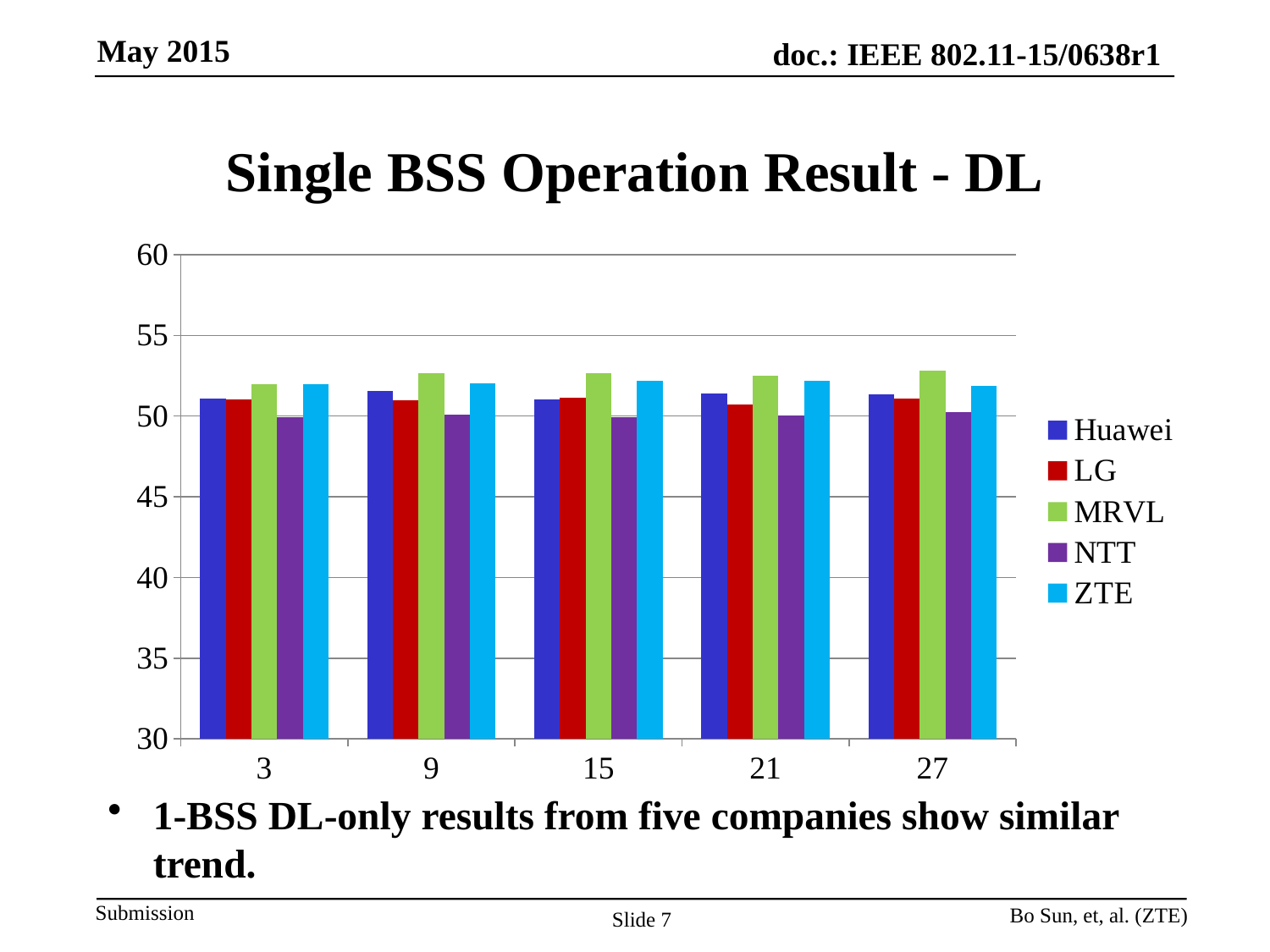
What is the title of the chart? Single BSS Operation Result - DL Which series is listed last in the legend? ZTE Is the value for MRVL at category 15 greater or less than 50? greater What kind of chart is shown on the slide? bar chart Which series has the highest value at category 15? MRVL Which series has the lowest value at category 9? NTT How many series does the legend list? 5 Is the value for LG at category 3 greater or less than 45? greater Is the value for Huawei at category 27 greater or less than 55? less How many categories are shown along the x axis? 5 At category 21, which is larger: the value for MRVL or the value for NTT? MRVL